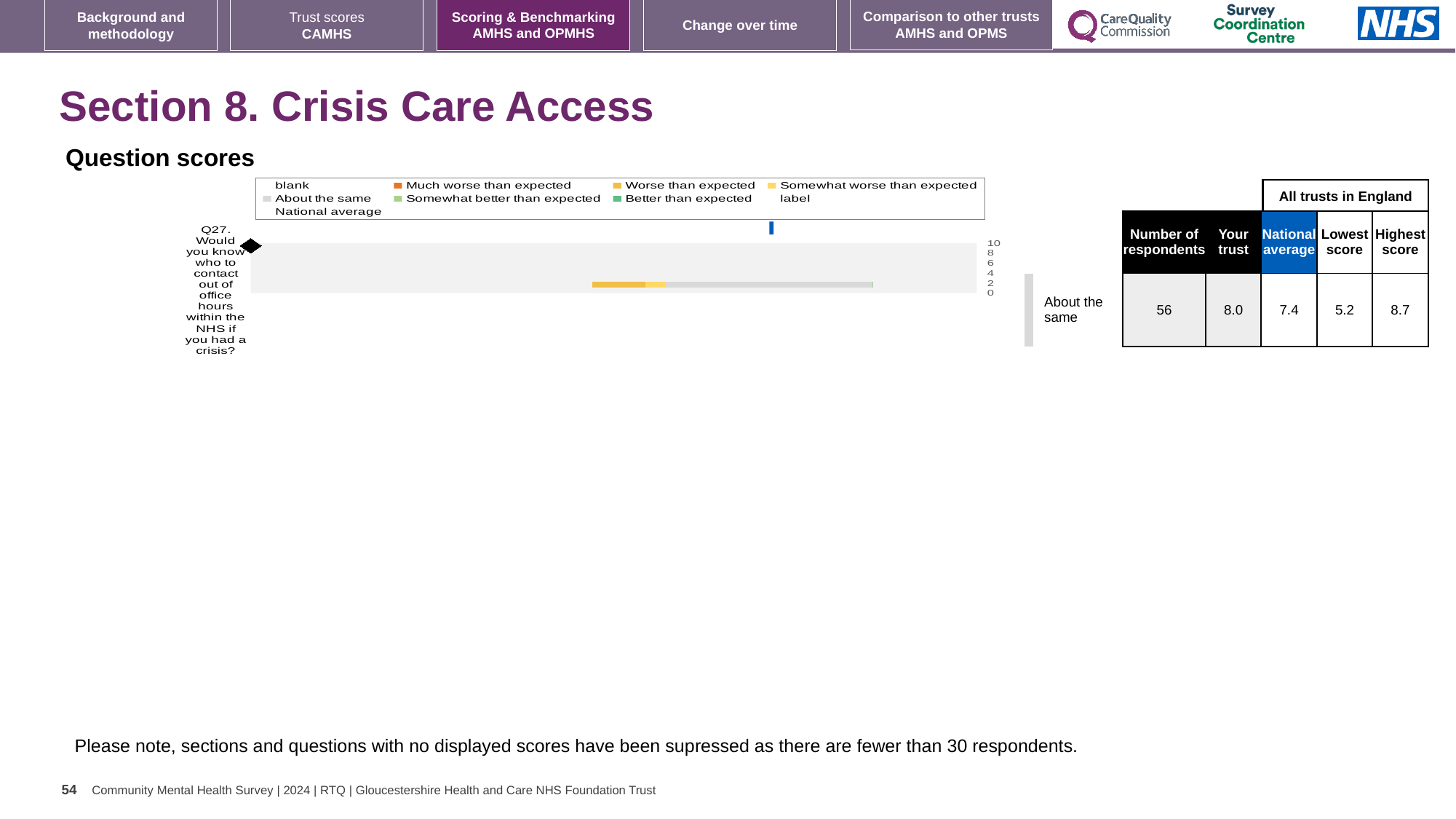
For Q27, what is the difference between the 'Your trust' score and the national average? 0.6 Which question is plotted in the Question scores chart? Q27. Would you know who to contact out of office hours within the NHS if you had a crisis? In the table beside the chart, what is the lowest score among all trusts in England for Q27? 5.2 In the table beside the chart, what is the number of respondents for Q27? 56 What benchmark category label is shown to the right of the Q27 bar? About the same For Q27, what is the difference between the highest score and the lowest score among all trusts in England? 3.5 In the table beside the chart, what is the 'Your trust' score for Q27? 8.0 What kind of chart is shown under 'Question scores'? bar chart How many questions (categories) are plotted in the Question scores chart? 1 In the table beside the chart, what is the national average score for Q27? 7.4 In the table beside the chart, what is the highest score among all trusts in England for Q27? 8.7 For Q27, which is larger: the 'Your trust' score or the national average? Your trust